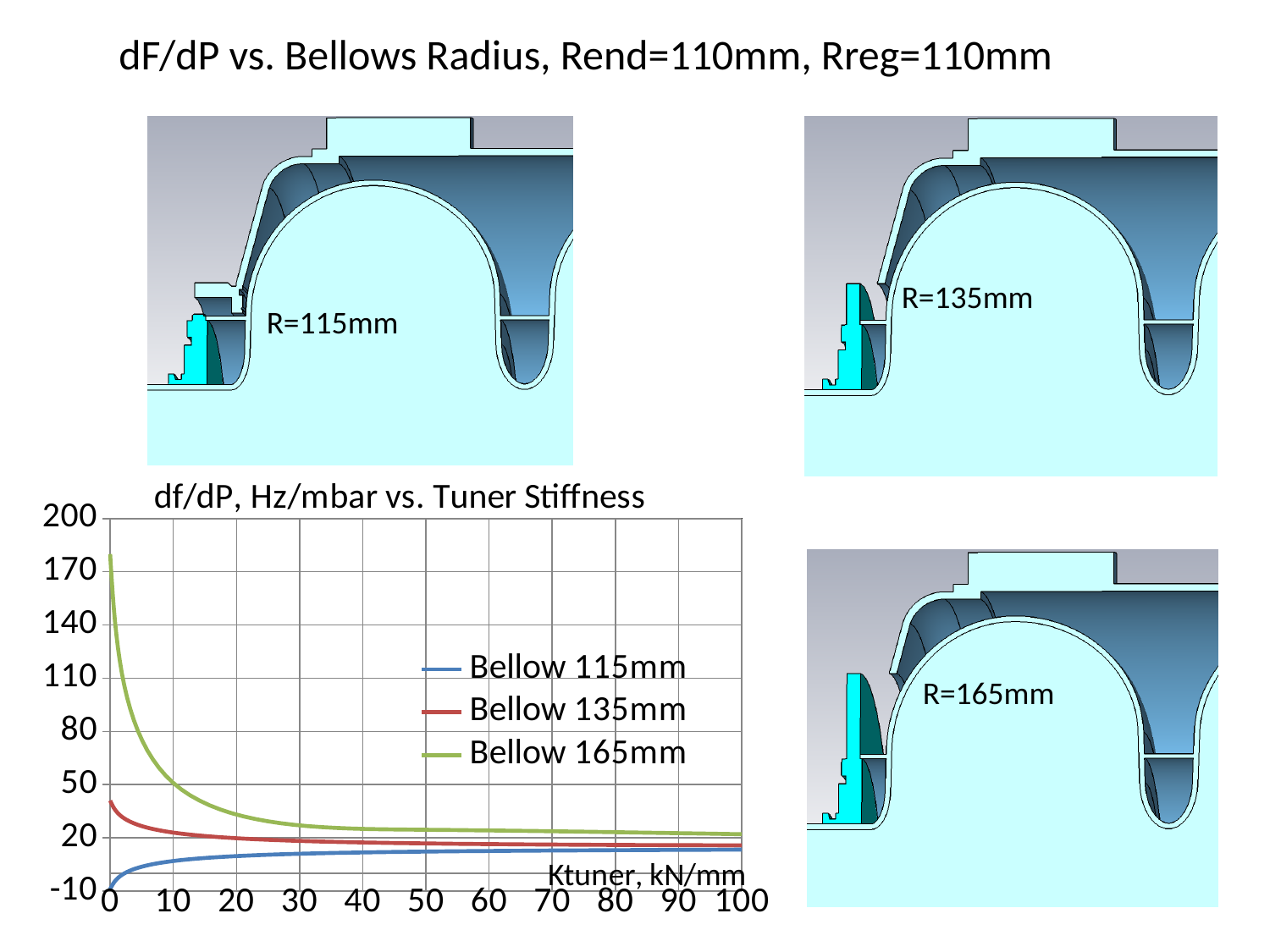
At Ktuner = 0, which series has the larger value, Bellow 165mm or Bellow 135mm? Bellow 165mm Which series has the highest value at Ktuner = 0? Bellow 165mm Does the Bellow 115mm series rise or fall as Ktuner increases? rise What is the title of the chart? df/dP, Hz/mbar vs. Tuner Stiffness Which series has the lowest value at Ktuner = 0? Bellow 115mm How many series does the legend of the chart list? 3 Does the Bellow 165mm series rise or fall as Ktuner increases? fall Is the value of the Bellow 165mm series at Ktuner = 0 greater or less than 140? greater What is the label of the x axis of the chart? Ktuner, kN/mm Is the value of the Bellow 135mm series at Ktuner = 0 greater or less than 50? less What kind of chart is shown on the slide? line chart Is the value of the Bellow 165mm series at Ktuner = 50 greater or less than 50? less